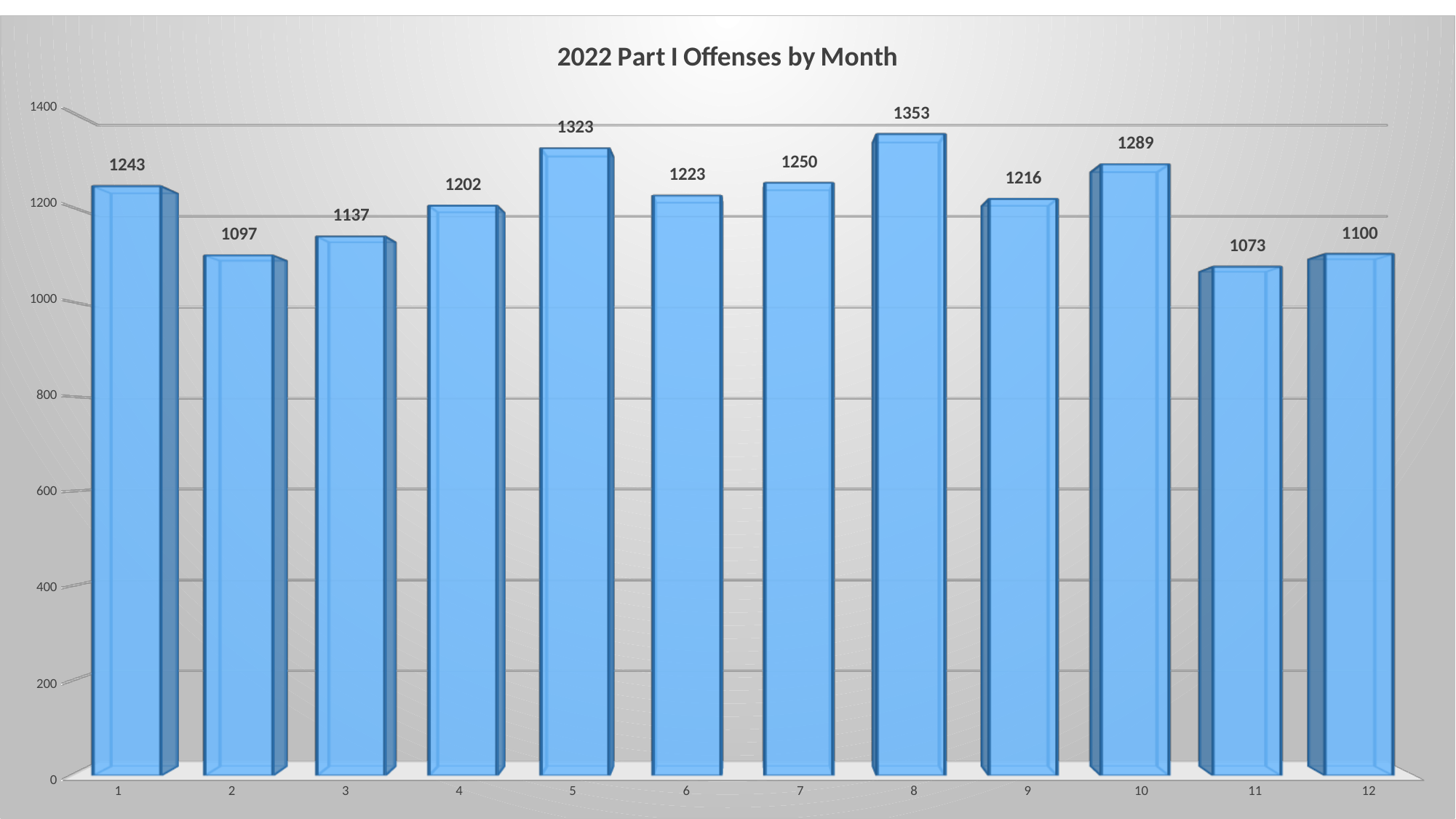
Which is larger, the value for month 4 or the value for month 6? month 6 What is the value for month 5? 1323 What is the value for month 11? 1073 What is the difference between the values for month 8 and month 11? 280 Which month has the lowest value? 11 What is the difference between the values for month 10 and month 9? 73 Which month has the highest value? 8 What is the title of the chart? 2022 Part I Offenses by Month What is the value for month 1? 1243 How many months are shown on the x axis? 12 Is the value for month 2 greater or less than 1200? less What kind of chart is shown on the slide? bar chart